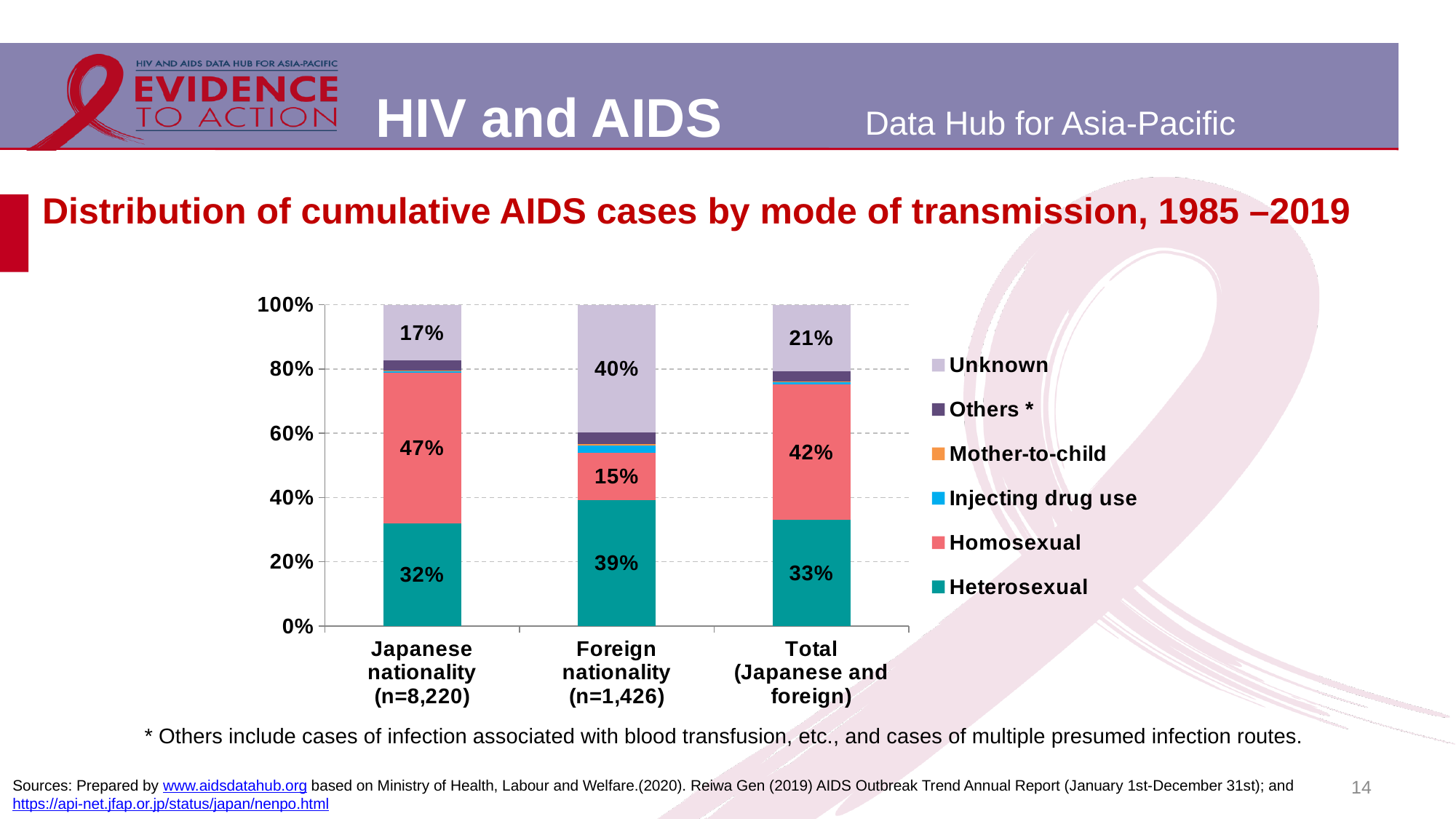
How many modes of transmission does the legend list? 6 Is the heterosexual transmission share larger for Japanese nationality or for foreign nationality? Foreign nationality What percentage of the Total (Japanese and foreign) cumulative AIDS cases were attributed to heterosexual transmission? 33% What is the heterosexual transmission share for foreign nationality (n=1,426)? 39% Which nationality group has the highest share of cases with unknown mode of transmission? Foreign nationality (n=1,426) Which colour represents the Unknown mode of transmission in the chart? Light purple What is the difference between the homosexual transmission share for Japanese nationality and for foreign nationality? 32 percentage points Which group has the lowest homosexual transmission share? Foreign nationality (n=1,426) How many nationality groups (bars) are shown on the x axis? 3 What share of cumulative AIDS cases among foreign nationality (n=1,426) had an unknown mode of transmission? 40% What type of chart is used to show the distribution of cumulative AIDS cases by mode of transmission? Stacked bar chart What percentage of cumulative AIDS cases among Japanese nationality (n=8,220) were attributed to homosexual transmission? 47%